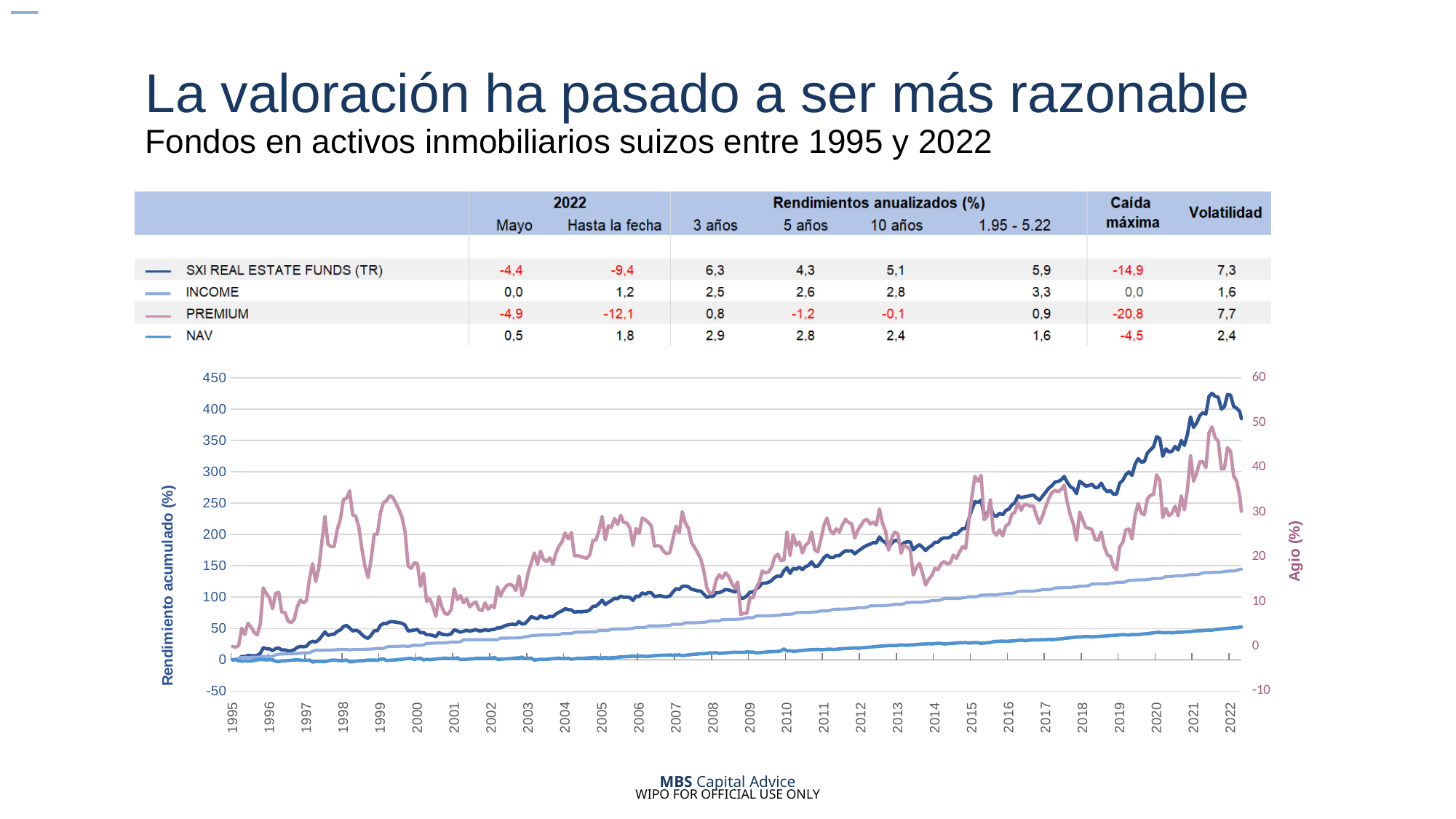
Is the cumulative return for SXI REAL ESTATE FUNDS (TR) in 2022 greater or less than 350? greater What is the title of the left vertical axis of the chart? Rendimiento acumulado (%) According to the table, what is the annualized return for SXI REAL ESTATE FUNDS (TR) over 1.95 - 5.22? 5,9 What kind of chart is shown on the slide? line chart Which series reaches the highest cumulative return on the left axis of the chart? SXI REAL ESTATE FUNDS (TR) How many year labels are shown on the x axis of the chart? 28 Is the cumulative return for NAV in 2022 greater or less than 100? less What is the title of the right vertical axis of the chart? Agio (%) Is the cumulative return for INCOME in 2022 greater or less than 100? greater How many series does the legend list for the chart? 4 Does the SXI REAL ESTATE FUNDS (TR) line rise or fall overall from 1995 to 2022? rise In 2022, which line is higher on the left axis: SXI REAL ESTATE FUNDS (TR) or INCOME? SXI REAL ESTATE FUNDS (TR)